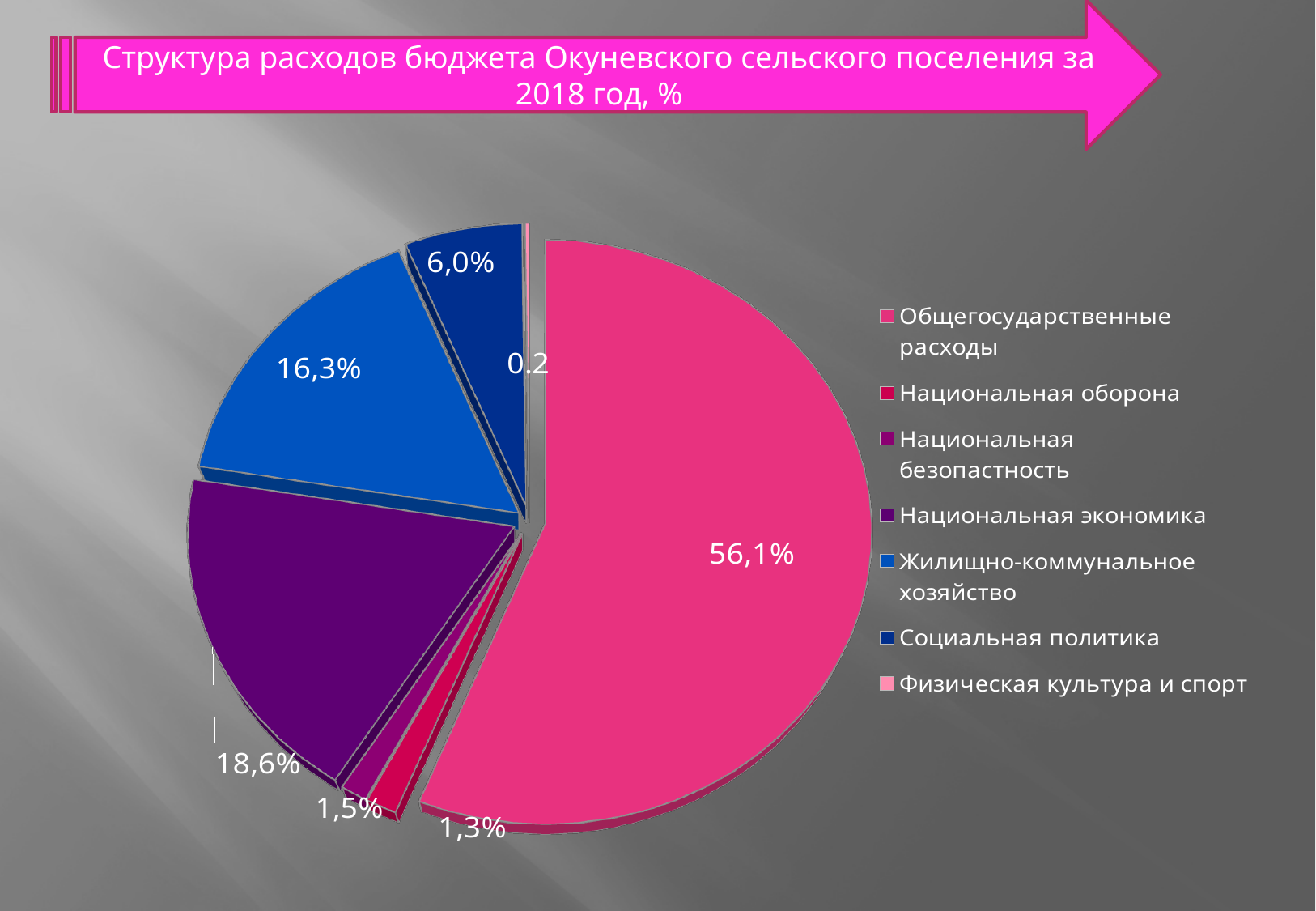
What is the title of the chart on the slide? Структура расходов бюджета Окуневского сельского поселения за 2018 год, % What is the share of Национальная экономика in the pie chart? 18,6% Which category has the largest share of the pie chart? Общегосударственные расходы What kind of chart is shown on the slide? pie chart What is the difference between the shares of Национальная экономика and Жилищно-коммунальное хозяйство? 2,3% How many categories does the legend of the pie chart list? 7 What is the share of Общегосударственные расходы in the pie chart? 56,1% What is the share of Жилищно-коммунальное хозяйство in the pie chart? 16,3% Which is larger: the share of Социальная политика or the share of Национальная безопастность? Социальная политика What is the share of Социальная политика in the pie chart? 6,0% Which category has the smallest share of the pie chart? Физическая культура и спорт